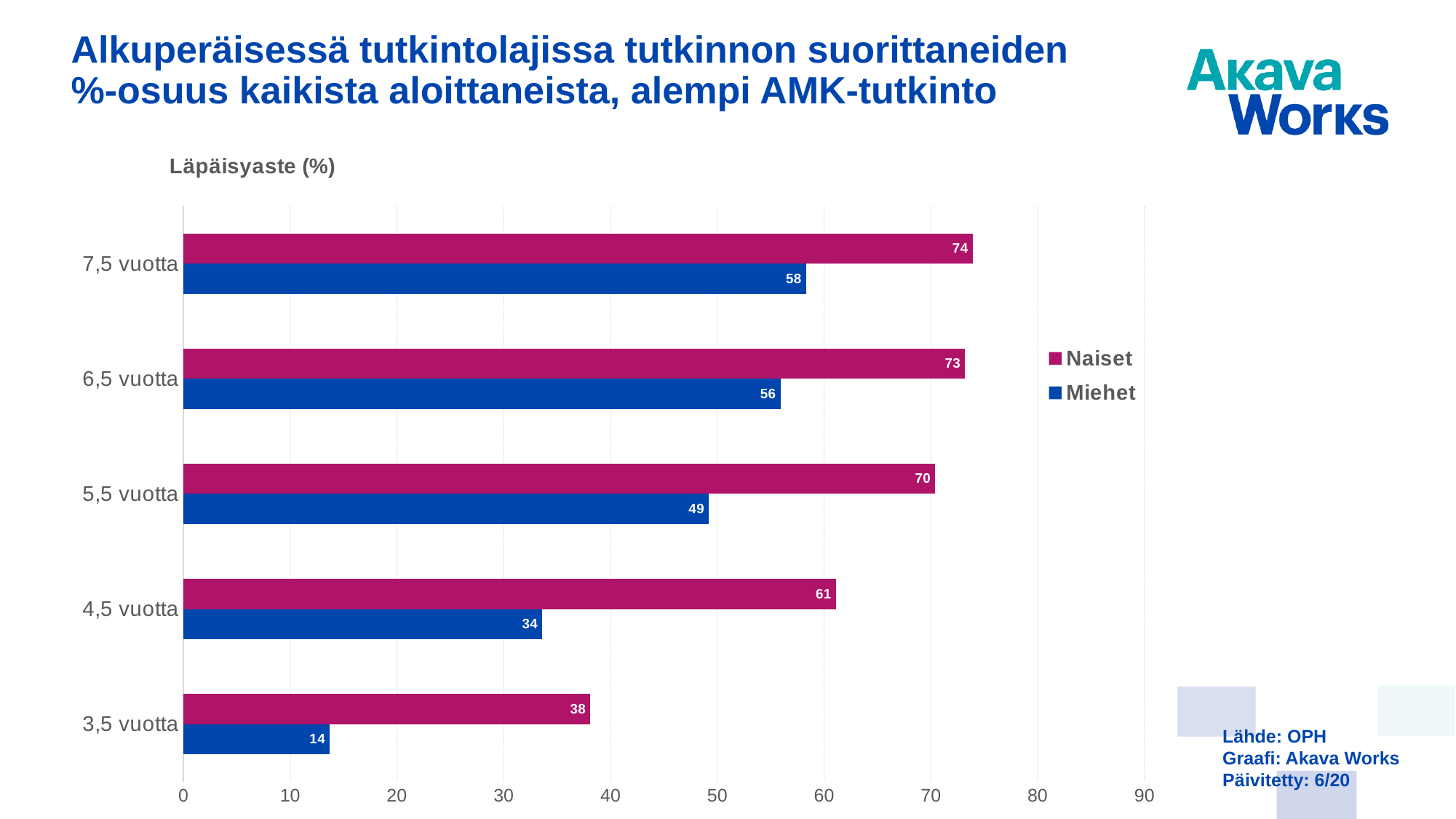
Which category has the highest value for Miehet? 7,5 vuotta What kind of chart is shown on the slide? Bar chart How many categories are shown on the y axis? 5 What is the value for Miehet at 3,5 vuotta? 14 What is the difference between Naiset and Miehet at 4,5 vuotta? 27 Which is larger at 6,5 vuotta, Naiset or Miehet? Naiset What is the value for Naiset at 7,5 vuotta? 74 What is the difference between the Naiset values at 7,5 vuotta and 3,5 vuotta? 36 How many series does the legend list? 2 Which category has the lowest value for Naiset? 3,5 vuotta What is the axis label shown above the chart? Läpäisyaste (%) What is the value for Miehet at 5,5 vuotta? 49